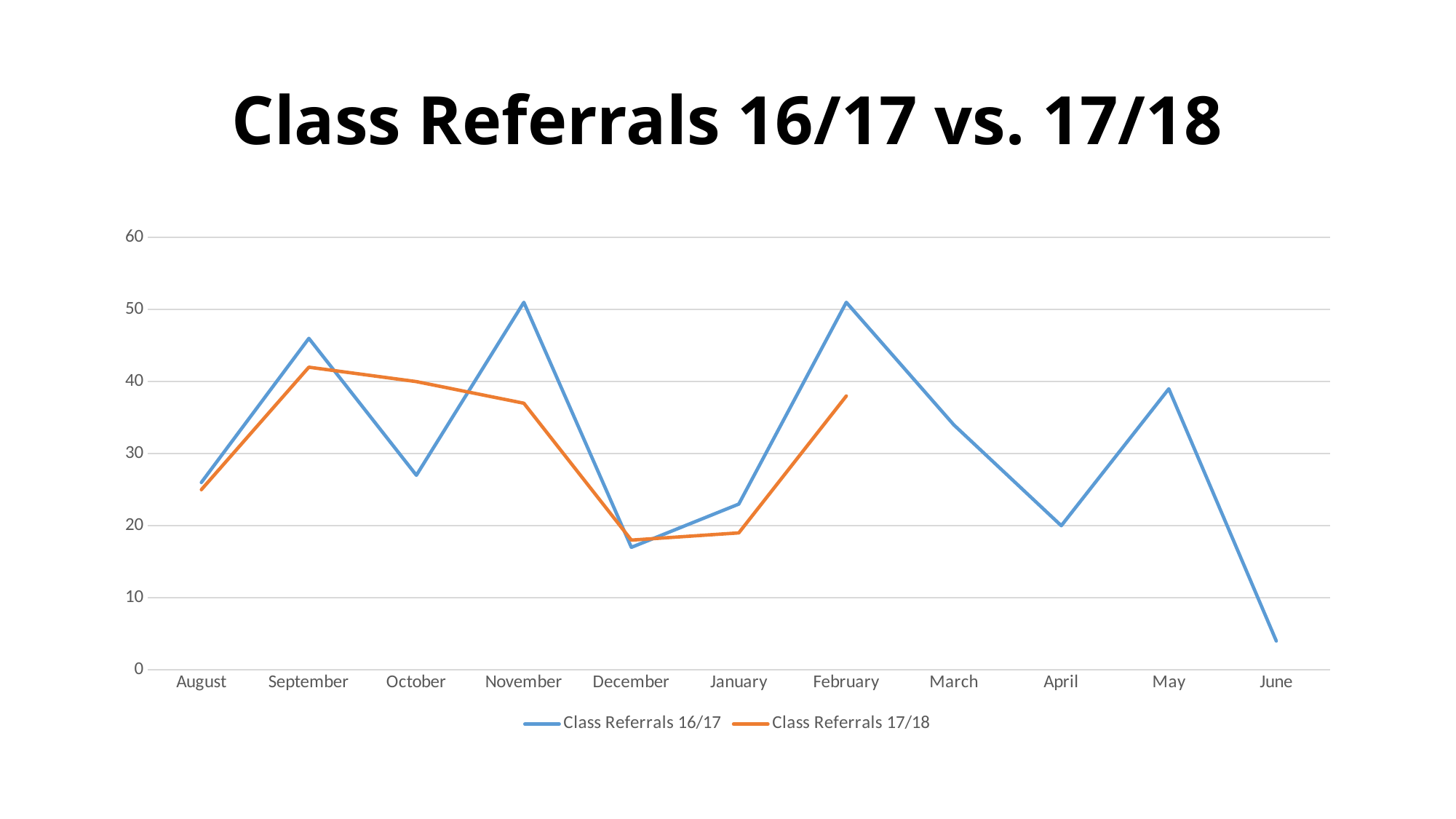
Is the value for Class Referrals 17/18 in October greater or less than 30? greater Is the value for Class Referrals 16/17 in September greater or less than 40? greater What colour is the line for Class Referrals 17/18? Orange How many series does the legend list? 2 In November, which series has the larger value, Class Referrals 16/17 or Class Referrals 17/18? Class Referrals 16/17 In October, which series has the larger value, Class Referrals 16/17 or Class Referrals 17/18? Class Referrals 17/18 Which month has the lowest value for Class Referrals 16/17? June How many months are shown along the x axis? 11 Does the Class Referrals 17/18 line rise or fall from September to November? Fall Is the value for Class Referrals 16/17 in December greater or less than 20? less What kind of chart is shown on the slide? Line chart